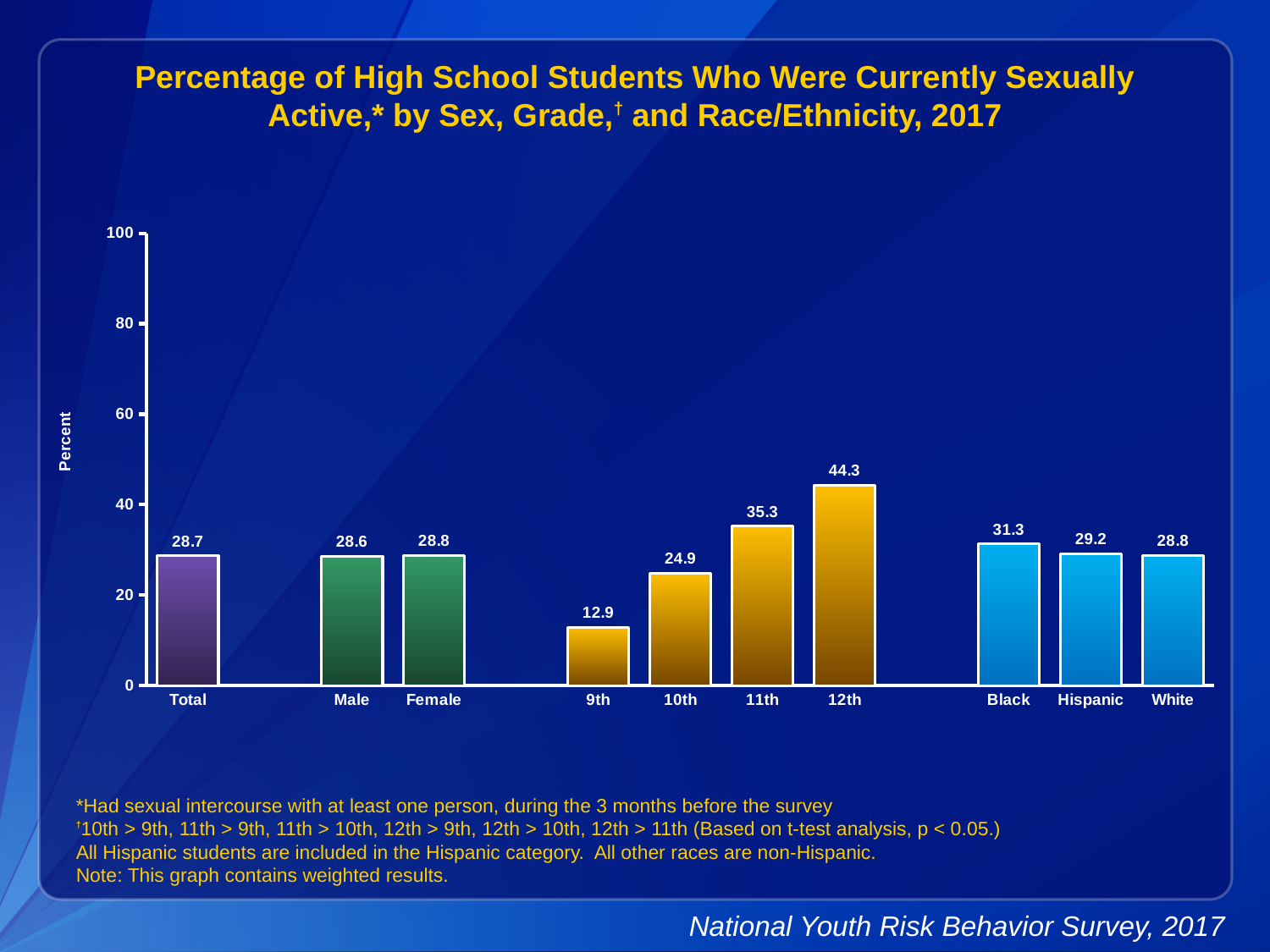
What is the value for Total? 28.7 Which is larger, the value for Black or the value for Hispanic? Black Which category has the lowest value? 9th What kind of chart is this? bar chart Do the values rise or fall from 9th to 12th grade? rise What is the value for 12th grade? 44.3 Which category has the highest value? 12th Is the value for 11th grade greater or less than 40? less What is the value for Black students? 31.3 What is the difference between the values for 12th and 9th grade? 31.4 What is the label on the y axis? Percent How many categories are shown on the x axis? 10